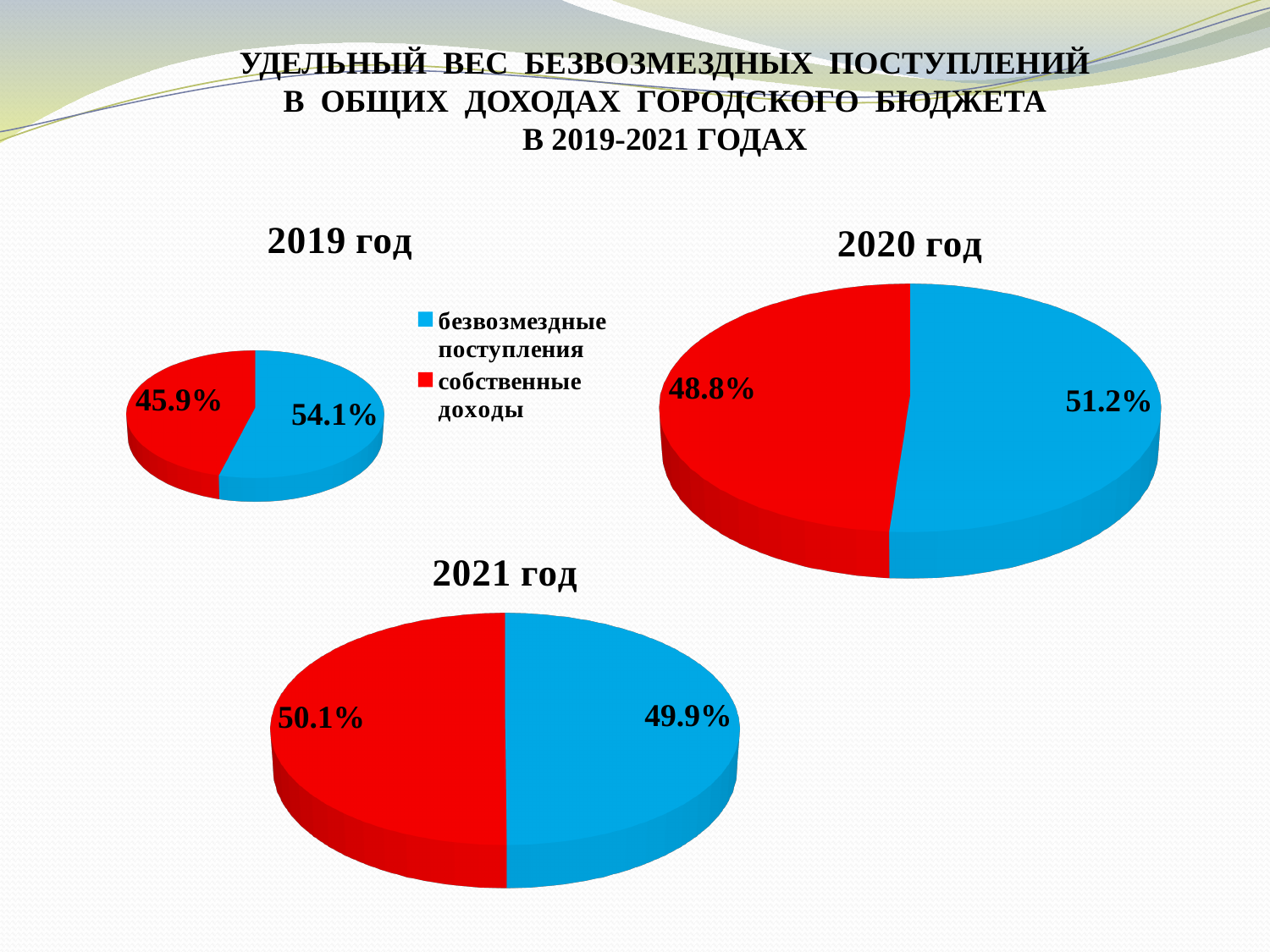
In the "2019 год" chart, what share is shown for безвозмездные поступления? 54.1% How many series does the legend list? 2 In the "2019 год" chart, what is the difference between the безвозмездные поступления share and the собственные доходы share? 8.2% In the "2020 год" chart, what share is shown for безвозмездные поступления? 51.2% What type of chart is used for the "2020 год" chart? Pie chart Which colour represents собственные доходы in the legend? Red In the "2020 год" chart, what is the difference between the безвозмездные поступления share and the собственные доходы share? 2.4% In the "2021 год" chart, what share is shown for собственные доходы? 50.1% In the "2019 год" chart, what share is shown for собственные доходы? 45.9% In the "2020 год" chart, what share is shown for собственные доходы? 48.8% In the "2021 год" chart, what share is shown for безвозмездные поступления? 49.9% In the "2019 год" chart, which slice is larger: безвозмездные поступления or собственные доходы? безвозмездные поступления